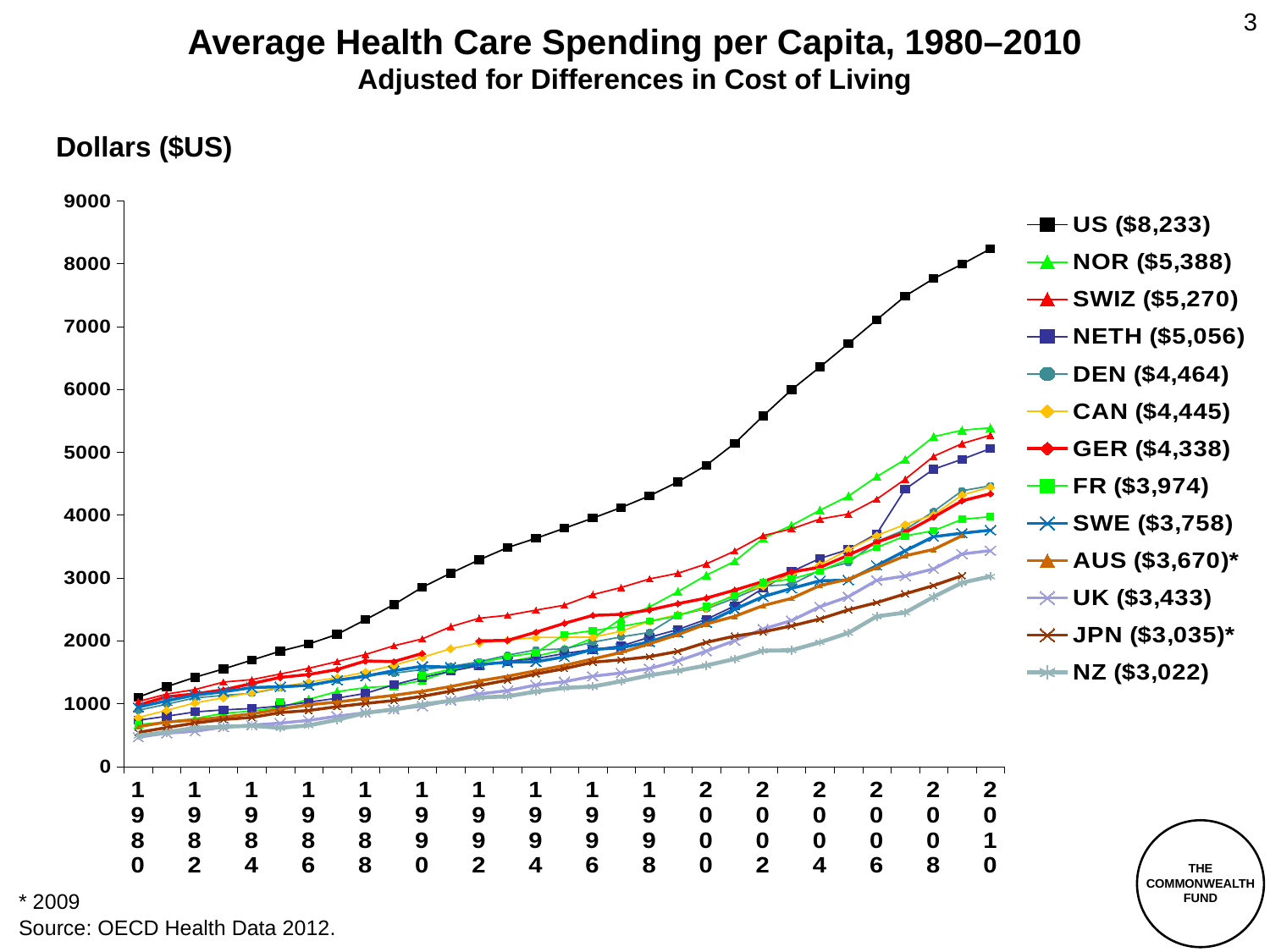
What is the value shown in the legend for US? $8,233 How many series does the legend list? 13 Does US health care spending per capita rise or fall from 1980 to 2010? rise Which country has the highest health care spending per capita in 2010? US Is the value for US in 2000 greater or less than 4000? greater What kind of chart is shown on the slide? line chart What is the value shown in the legend for NOR? $5,388 What is the value shown in the legend for JPN? $3,035 What is the difference between the legend values for US and NOR? $2,845 Which has a larger legend value, SWIZ or NETH? SWIZ What unit is shown on the y axis? Dollars ($US) Which country has the lowest value listed in the legend? NZ